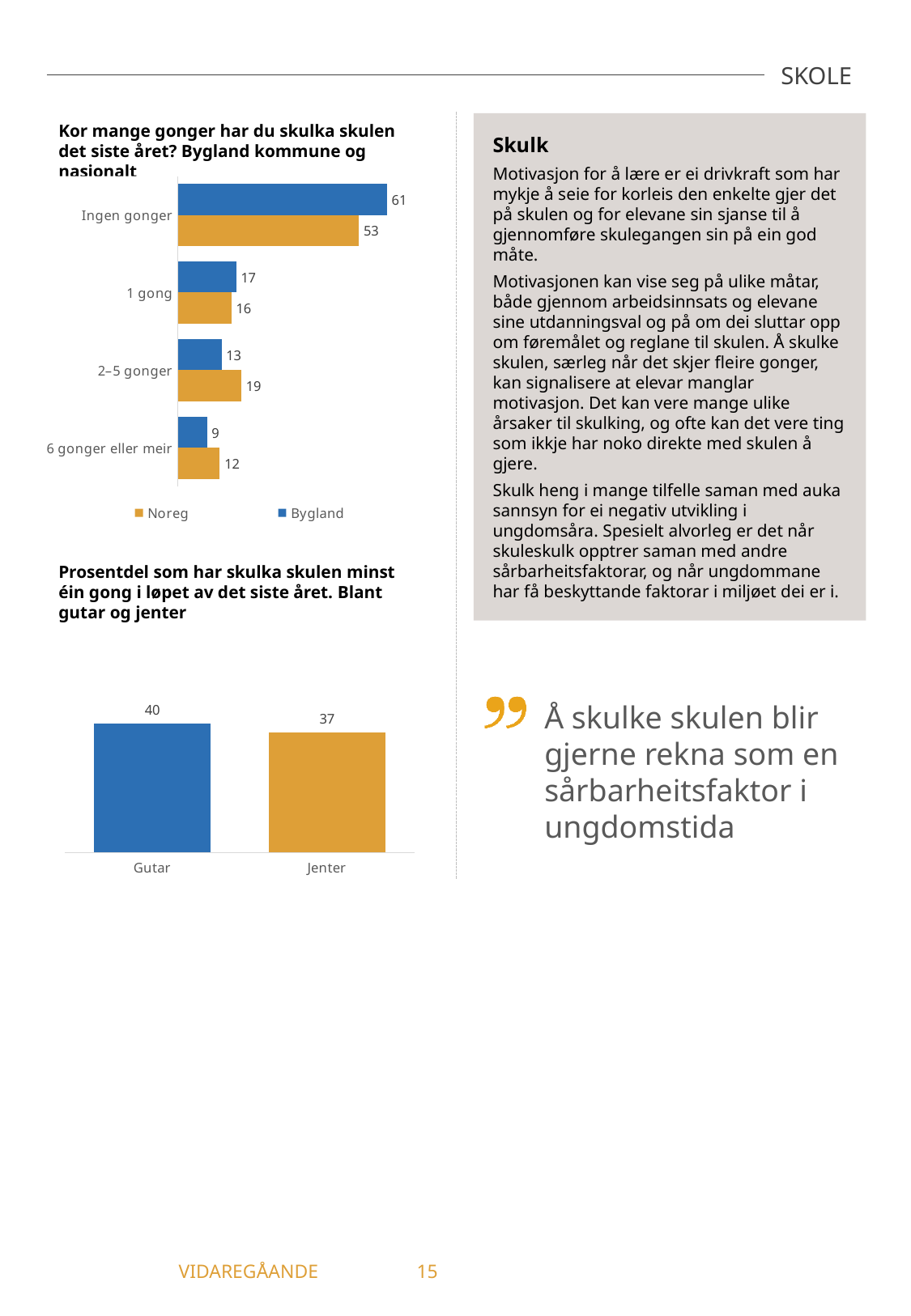
How many categories does the top chart show? 4 How many series does the legend of the top chart list? 2 In the bottom chart, what is the value for Gutar? 40 In the top chart, which category has the lowest value for Noreg? 6 gonger eller meir In the top chart, what is the difference between Bygland and Noreg for 'Ingen gonger'? 8 In the top chart, what is the value for Noreg for '6 gonger eller meir'? 12 In the bottom chart, what is the difference between Gutar and Jenter? 3 In the top chart, what is the value for Noreg for '2–5 gonger'? 19 In the top chart, which is larger for '2–5 gonger', Bygland or Noreg? Noreg What kind of chart is the bottom chart? Bar chart In the top chart, which category has the highest value for Bygland? Ingen gonger In the top chart, what is the value for Bygland for 'Ingen gonger'? 61